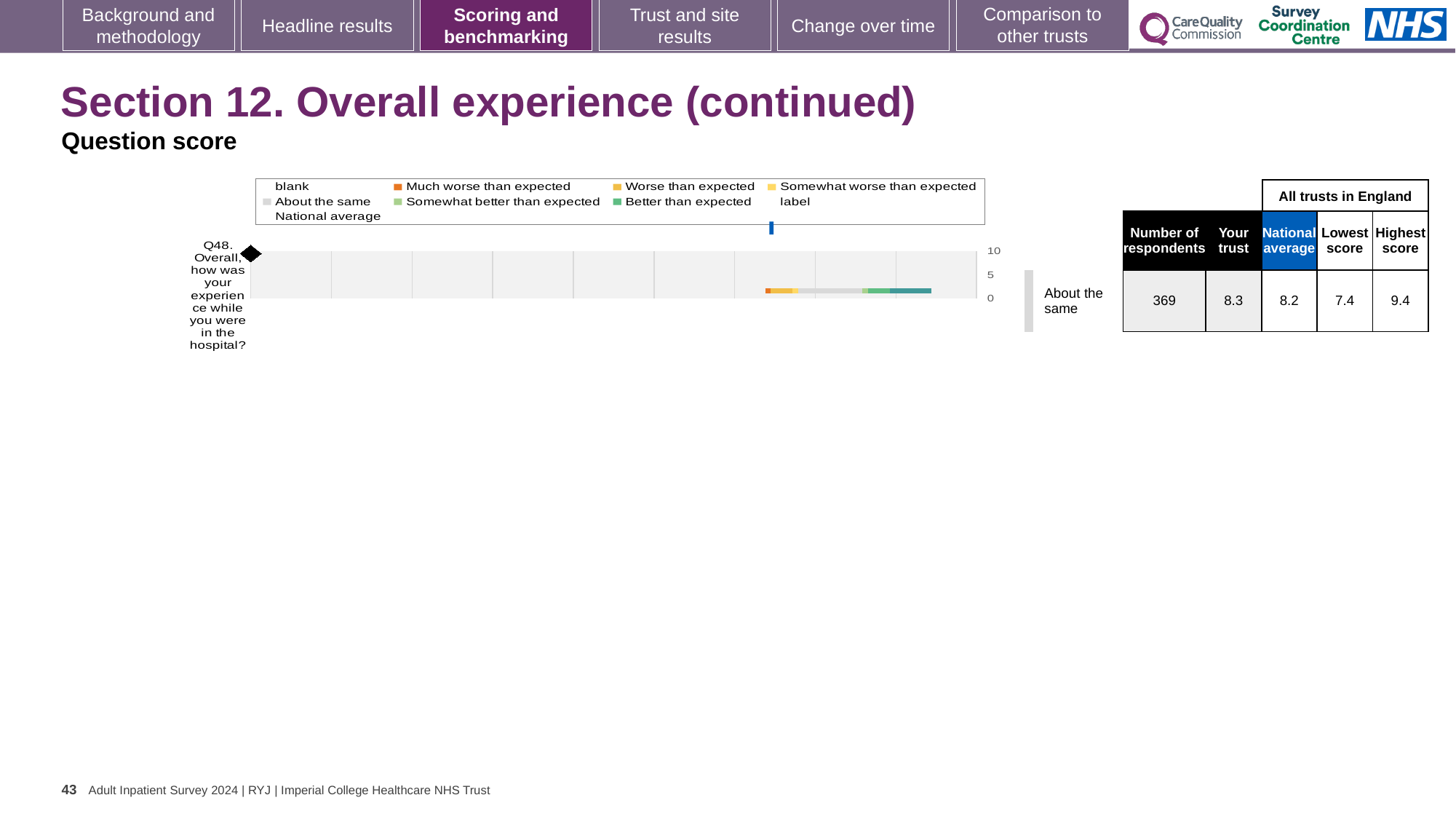
What is the highest value shown on the chart's numeric axis? 10 According to the table beside the chart, what is the national average score for Q48? 8.2 What is the difference between the highest score and the lowest score for Q48 in the table beside the chart? 2.0 According to the table beside the chart, what is the lowest score among all trusts in England for Q48? 7.4 Which question is plotted in the chart? Q48. Overall, how was your experience while you were in the hospital? According to the table beside the chart, what is the highest score among all trusts in England for Q48? 9.4 Which is larger for Q48, the 'Your trust' score or the national average? Your trust According to the table beside the chart, how many respondents answered Q48? 369 What kind of chart is shown on the slide for Q48? bar chart According to the table beside the chart, what is the 'Your trust' score for Q48? 8.3 How many survey questions are plotted in the chart? 1 Which benchmark category is the trust placed in for Q48? About the same